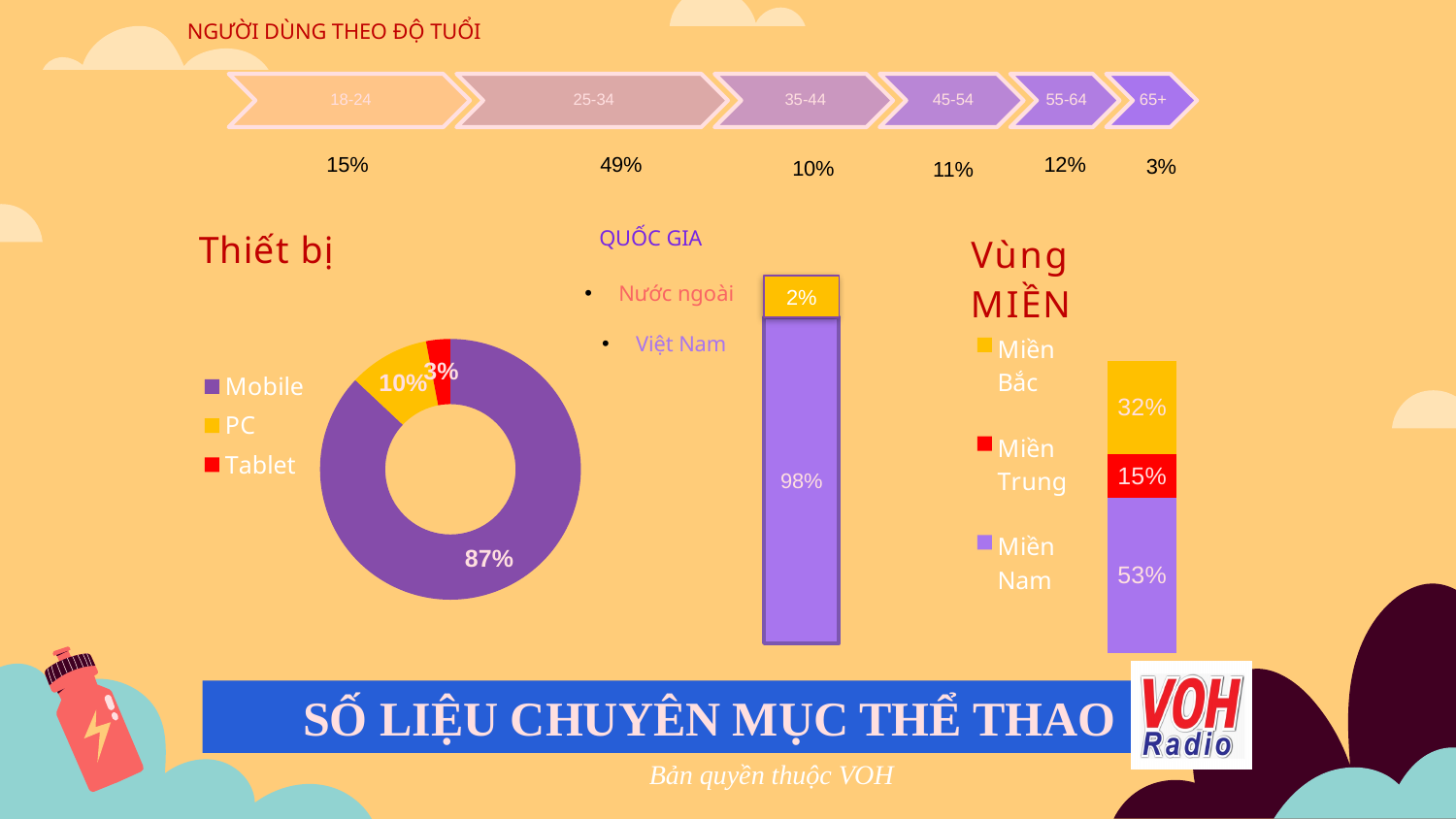
How many categories does the legend of the "Thiết bị" chart list? 3 In the "Vùng MIỀN" chart, which region has the highest percentage? Miền Nam What kind of chart is the "Thiết bị" chart? Donut chart In the "Vùng MIỀN" chart, which is larger: Miền Bắc or Miền Trung? Miền Bắc In the "Thiết bị" donut chart, what percentage is shown for PC? 10% In the "QUỐC GIA" chart, what percentage is shown for Việt Nam? 98% In the "Thiết bị" donut chart, what percentage is shown for Mobile? 87% In the "QUỐC GIA" chart, what percentage is shown for Nước ngoài? 2% In the "Vùng MIỀN" chart, what percentage is shown for Miền Nam? 53% In the "Thiết bị" donut chart, which device has the smallest share? Tablet In the "Vùng MIỀN" chart, what is the total of the three stacked segments? 100% In the "Thiết bị" donut chart, what is the difference between the Mobile and PC shares? 77%